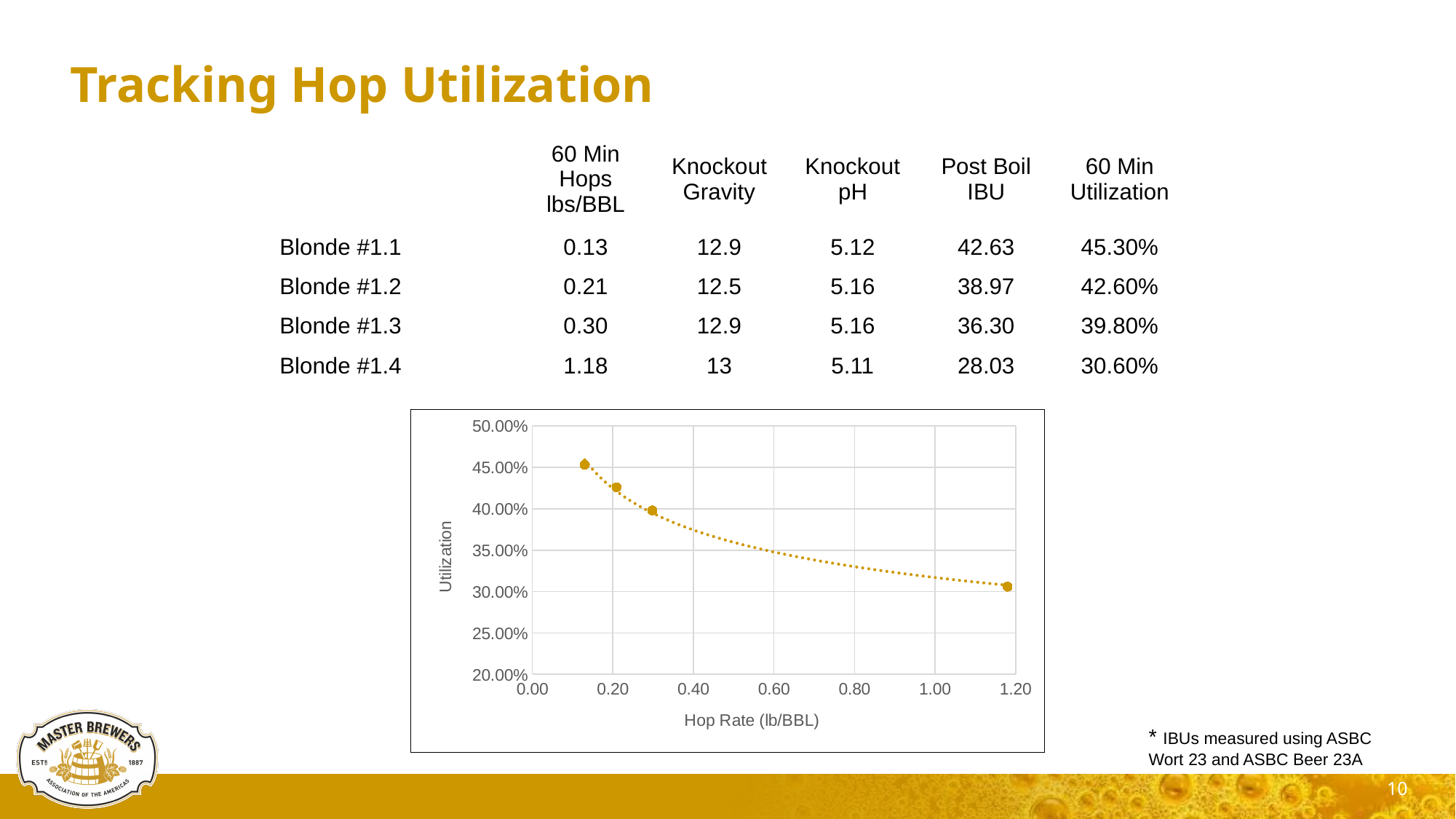
What kind of chart is shown on the slide? scatter chart Is the utilization at a hop rate of 1.18 lb/BBL greater or less than 35.00%? less What is the difference in utilization between the points at hop rates 0.13 and 1.18 lb/BBL? 14.70% What is the label of the x axis of the chart? Hop Rate (lb/BBL) Does utilization rise or fall as hop rate increases along the x axis? fall What is the label of the y axis of the chart? Utilization What is the utilization plotted at a hop rate of 0.13 lb/BBL? 45.30% Is the utilization at a hop rate of 0.30 lb/BBL greater or less than 35.00%? greater Which hop rate has the highest utilization on the chart? 0.13 How many data points are plotted on the chart? 4 What is the utilization plotted at a hop rate of 1.18 lb/BBL? 30.60% Which hop rate has the lowest utilization on the chart? 1.18